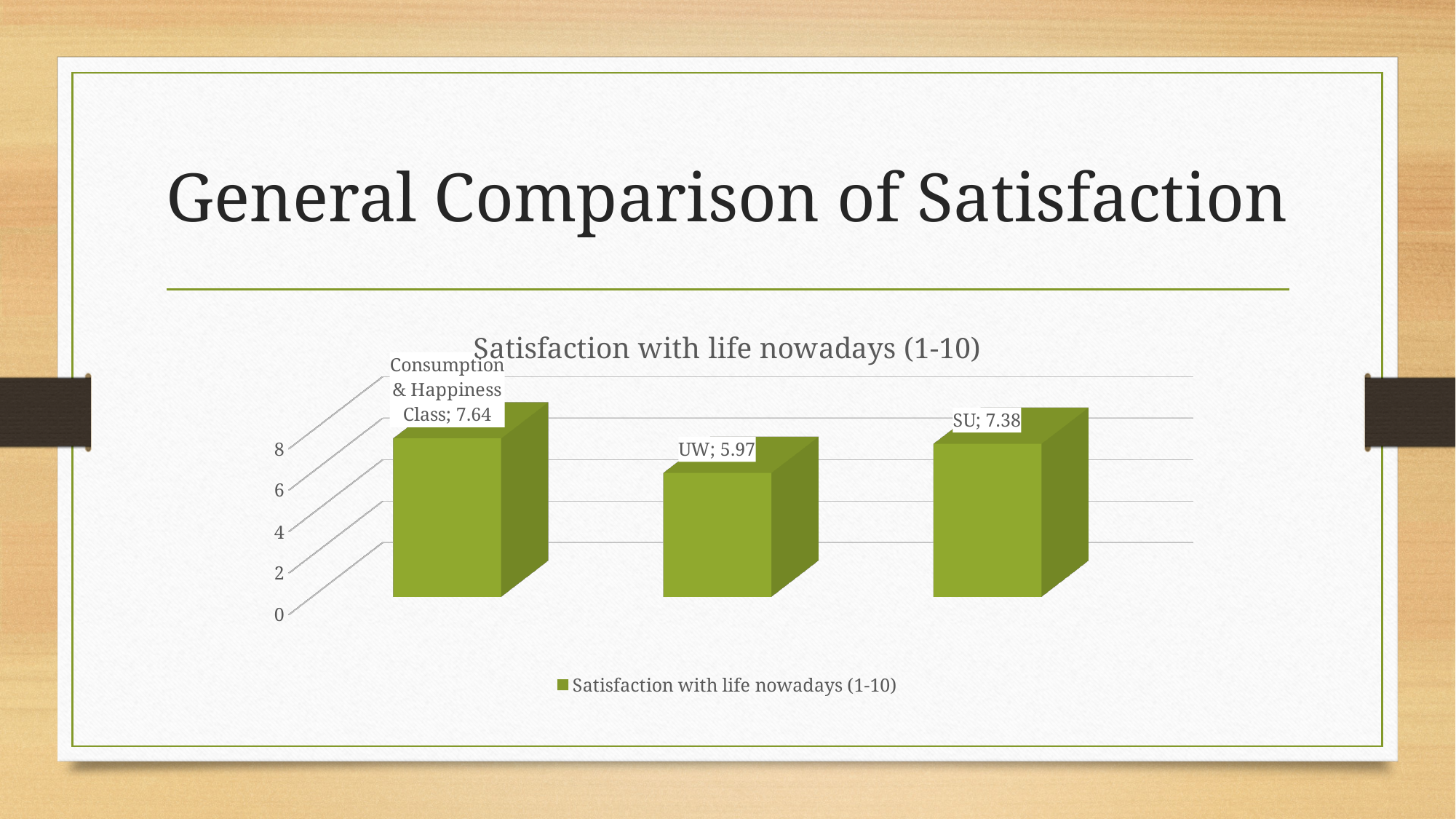
How many categories are shown in the chart? 3 What is the satisfaction value for SU? 7.38 What is the difference between the satisfaction values for the Consumption & Happiness Class and UW? 1.67 Which category has the highest satisfaction value? Consumption & Happiness Class Which has a higher satisfaction value, SU or UW? SU What is the title of the chart? Satisfaction with life nowadays (1-10) What is the satisfaction value for UW? 5.97 Is the value for UW greater or less than 6? less What kind of chart is shown on the slide? bar chart What is the difference between the satisfaction values for SU and UW? 1.41 What is the satisfaction value for the Consumption & Happiness Class? 7.64 Which category has the lowest satisfaction value? UW